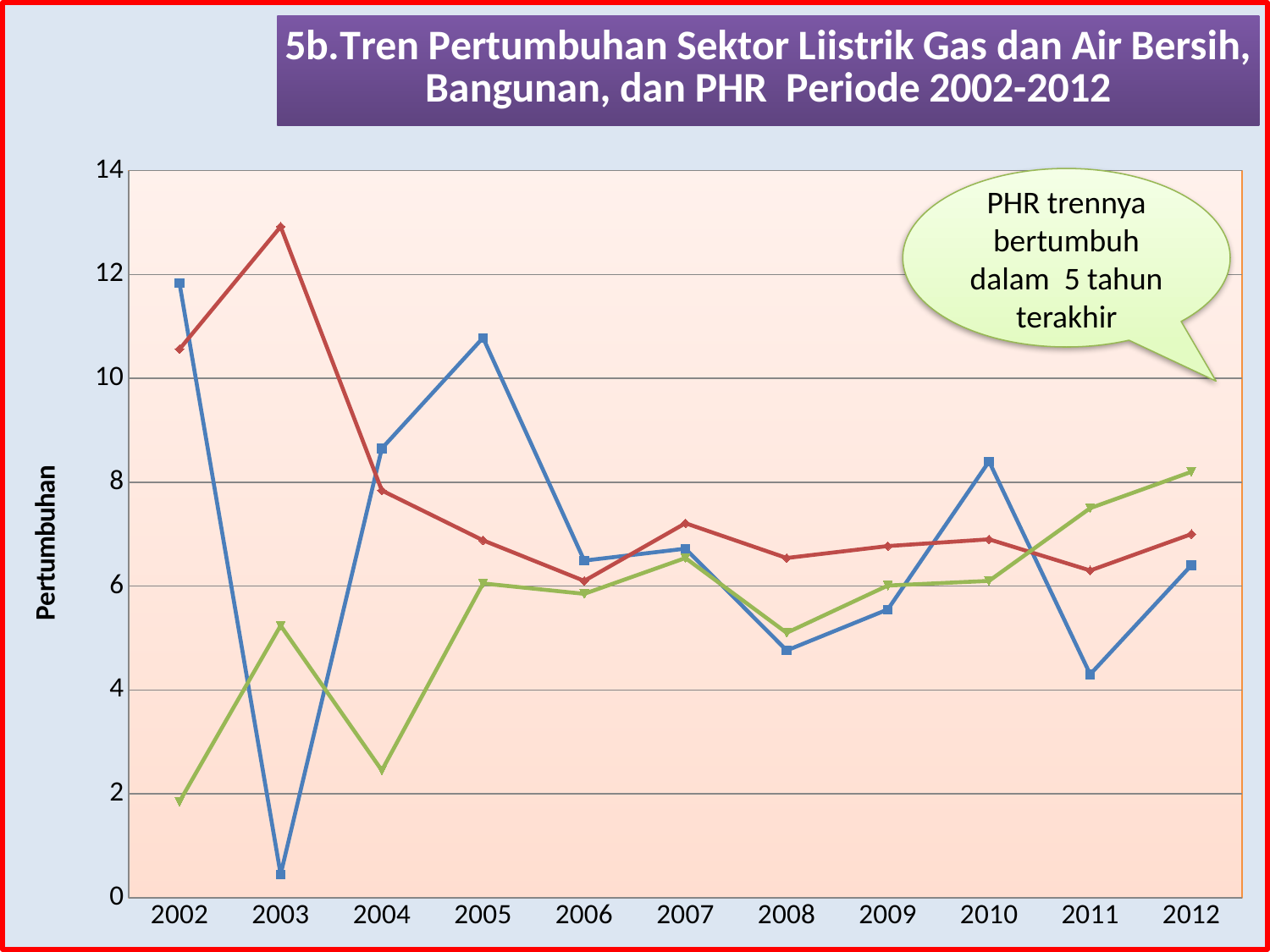
In which year does the blue line reach its lowest value? 2003 What is the label on the vertical axis of the chart? Pertumbuhan Is the value of the blue line in 2002 greater or less than 10? greater How many years are shown along the x axis of the chart? 11 In which year does the red line reach its highest value? 2003 In which year does the blue line reach its highest value? 2002 In which year does the green line reach its lowest value? 2002 Is the value of the green line in 2004 greater or less than 4? less Is the value of the red line in 2011 greater or less than 8? less How many lines are plotted on the chart? 3 Does the green line rise or fall from 2008 to 2012? rise What kind of chart is shown on the slide? line chart